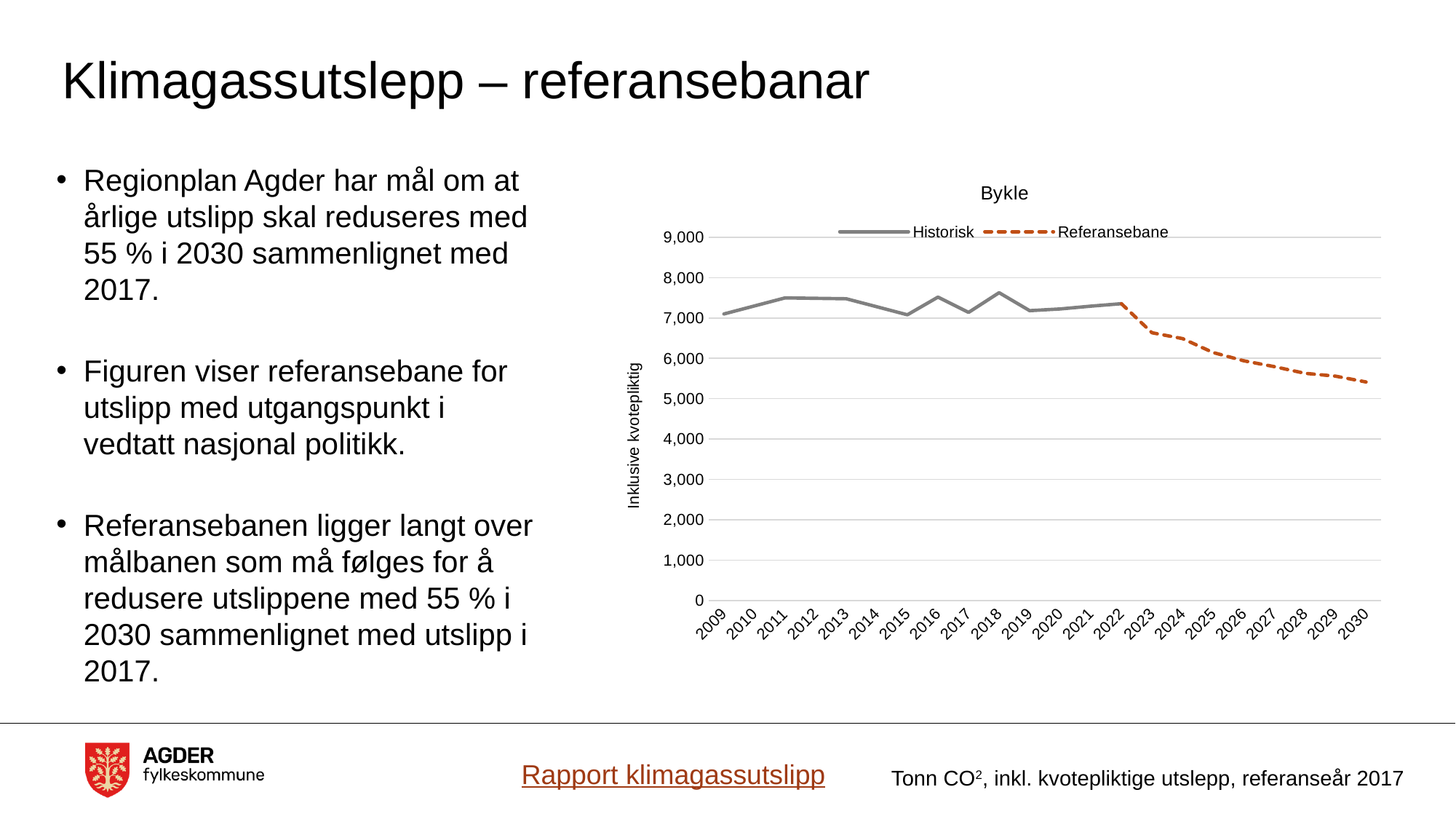
Which year has the lowest Referansebane value? 2030 Which series is drawn with a dashed line? Referansebane Is the Historisk value for 2009 greater or less than 8,000? less Is the Referansebane value for 2030 greater or less than 6,000? less What kind of chart is shown on the slide? line chart Is the Historisk value for 2018 greater or less than 7,000? greater Which is larger, the Historisk value for 2009 or for 2011? 2011 How many series does the chart legend list? 2 What is the title of the chart? Bykle Does the Referansebane series rise or fall from 2023 to 2030? fall How many years are shown on the x axis of the chart? 22